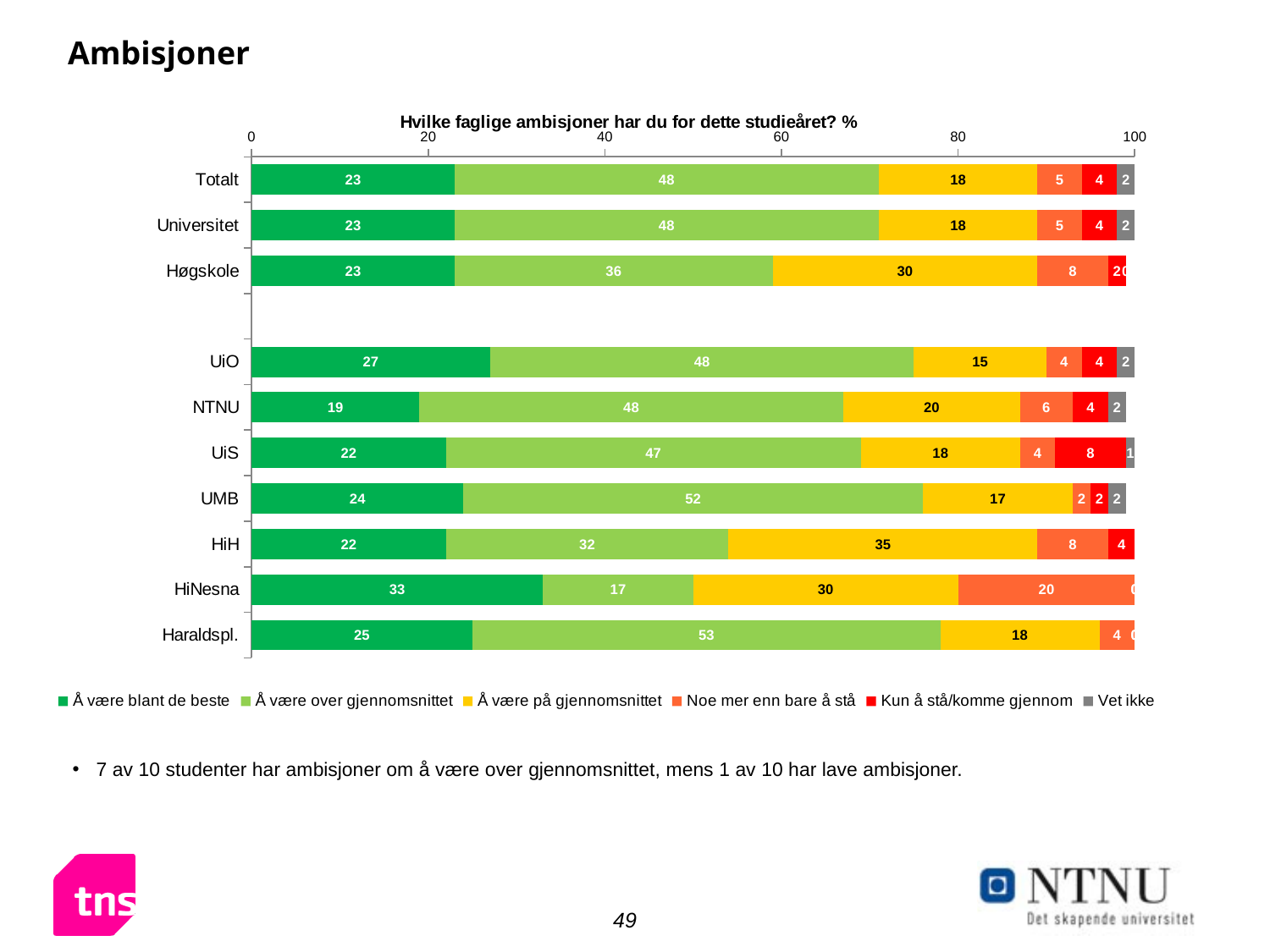
What is the value of 'Å være over gjennomsnittet' for Haraldspl.? 53 How many series does the legend list? 6 What is the difference between the 'Å være over gjennomsnittet' values for UMB and HiH? 20 What is the title of the chart? Hvilke faglige ambisjoner har du for dette studieåret? % What is the total of the stacked bar for Totalt? 100 What kind of chart is shown on the slide? Stacked bar chart Which is larger: the 'Noe mer enn bare å stå' value for HiNesna or for Høgskole? HiNesna What is the value of 'Å være blant de beste' for UiO? 27 How many categories (rows) are plotted in the chart? 10 Which category has the highest value for 'Å være blant de beste'? HiNesna Which category has the lowest value for 'Å være blant de beste'? NTNU What is the value of 'Å være på gjennomsnittet' for HiH? 35